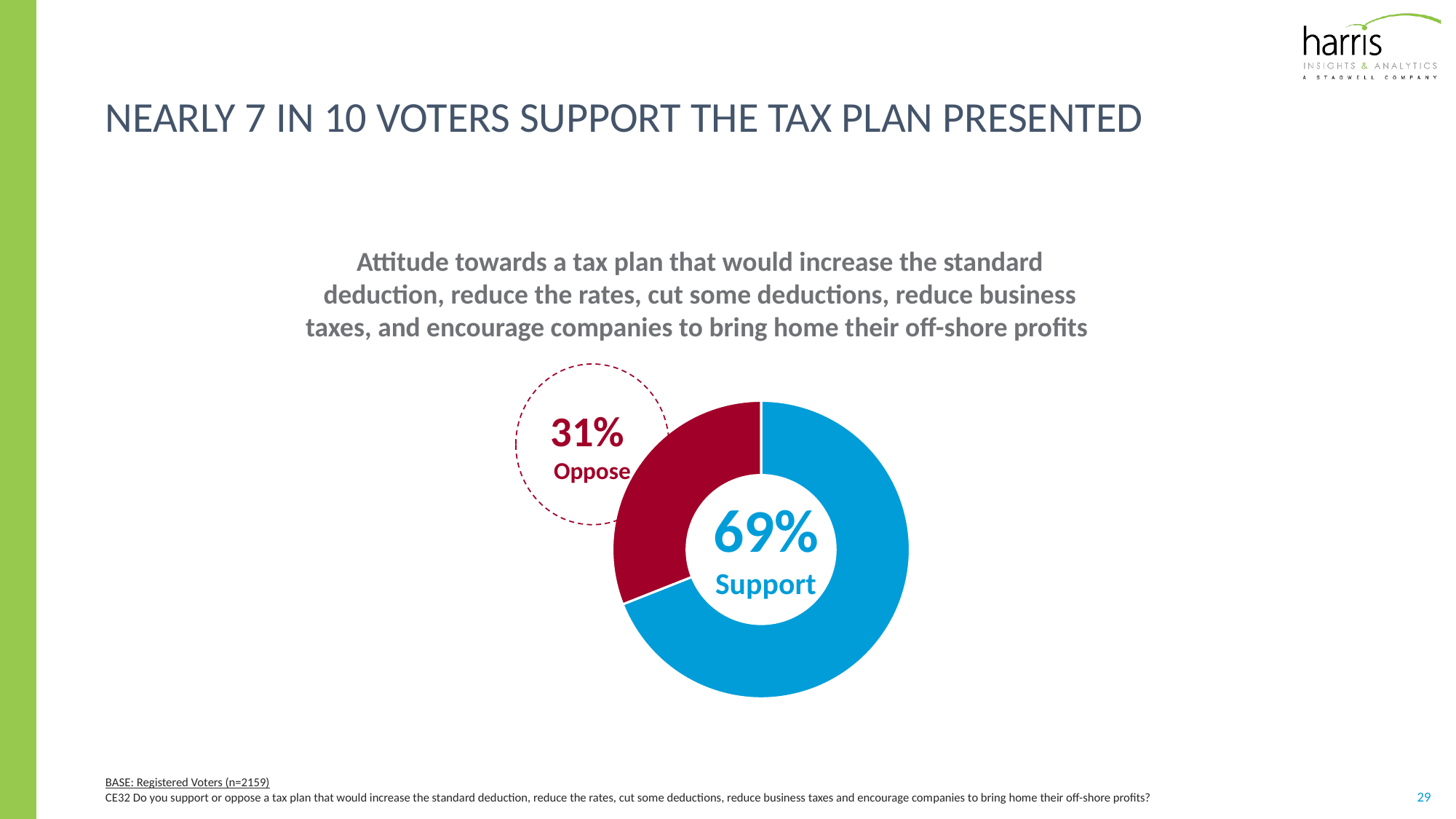
How many slices does the chart have? 2 What percentage of voters support the tax plan? 69% Is the share for Oppose greater or less than 50%? less Which response has the larger share: Support or Oppose? Support What colour is the Support slice? Blue What is the total of the Support and Oppose shares? 100% What colour is the Oppose slice? Red What is the difference in percentage points between Support and Oppose? 38 What percentage of voters oppose the tax plan? 31% Which response has the smallest share of the pie? Oppose What kind of chart is shown on the slide? Doughnut chart